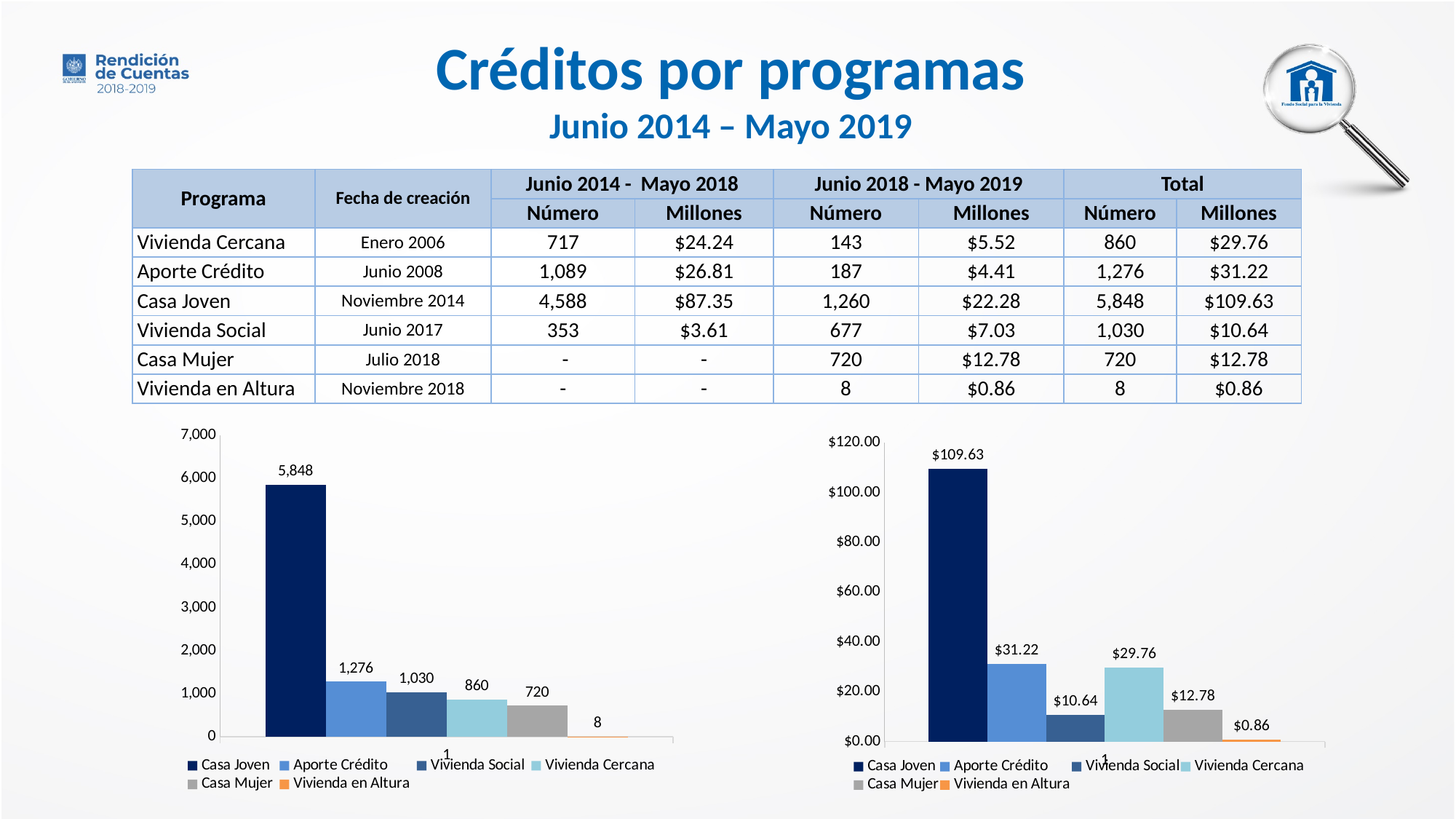
In the left chart, what is the difference between Aporte Crédito and Vivienda Social? 246 In the right chart, which is larger, Aporte Crédito or Vivienda Cercana? Aporte Crédito What kind of chart is the left chart? bar chart In the left chart, what is the value for Casa Mujer? 720 In the left chart, which series has the highest value? Casa Joven In the right chart, which series has the lowest value? Vivienda en Altura In the right chart, what is the value for Vivienda Cercana? $29.76 In the left chart, what is the value for Casa Joven? 5,848 How many series does the legend of the right chart list? 6 In the right chart, what is the difference between Casa Joven and Aporte Crédito? $78.41 In the left chart, is the value for Vivienda Cercana greater or less than 1,000? less In the right chart, what is the value for Vivienda en Altura? $0.86